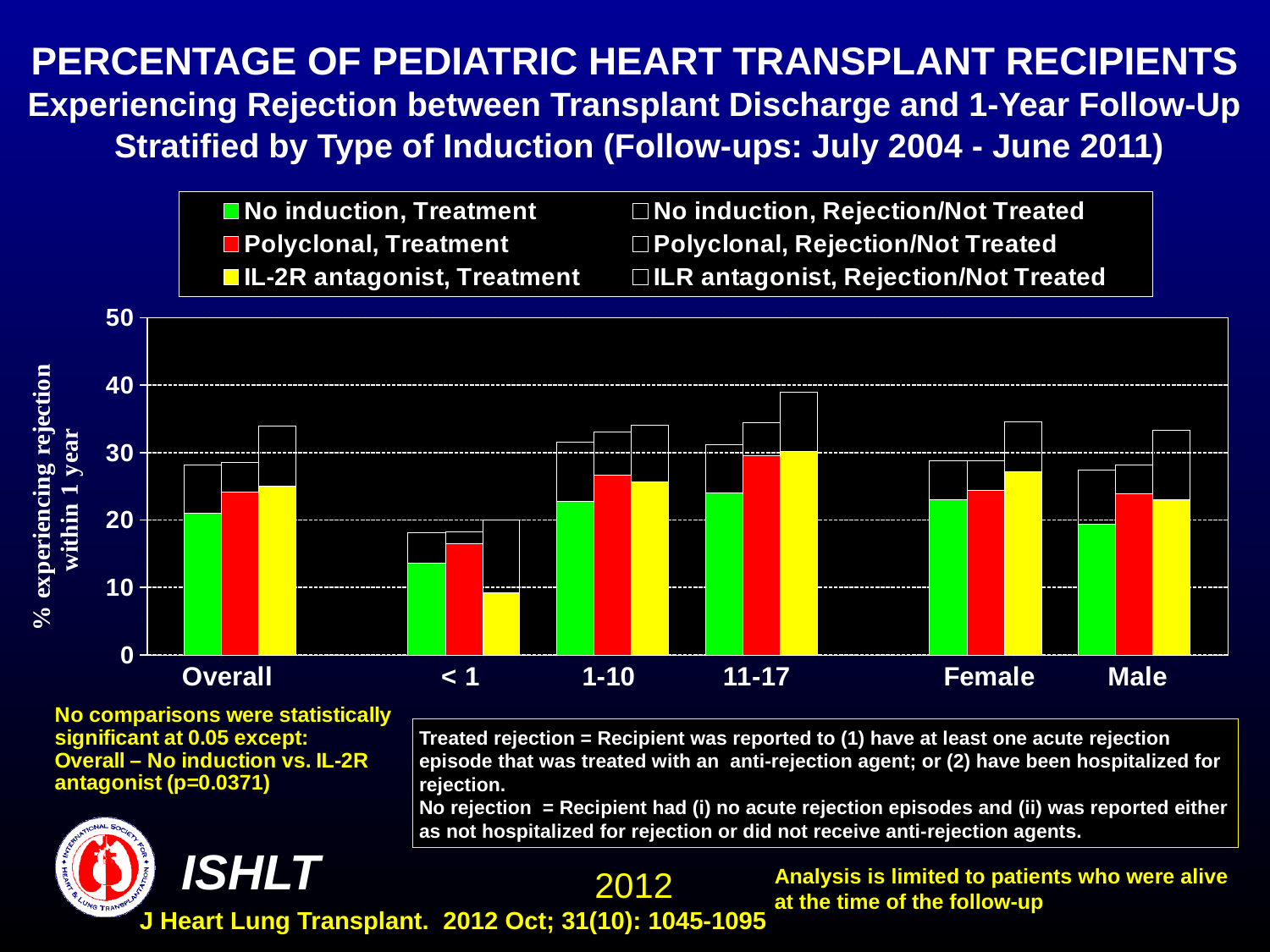
How many categories are shown along the x axis of the chart? 6 Which category has the lowest value for the IL-2R antagonist, Treatment series? < 1 In the 11-17 category, which is larger: the No induction, Treatment value or the Polyclonal, Treatment value? Polyclonal, Treatment What kind of chart is shown on the slide? bar chart Is the IL-2R antagonist, Treatment value for the Female category greater or less than 20? greater Is the Polyclonal, Treatment value for the 1-10 category greater or less than 20? greater Is the No induction, Treatment value for the < 1 category greater or less than 20? less In the < 1 category, which is larger: the Polyclonal, Treatment value or the IL-2R antagonist, Treatment value? Polyclonal, Treatment Which category has the highest value for the Polyclonal, Treatment series? 11-17 How many series does the chart's legend list? 6 Which category has the lowest value for the No induction, Treatment series? < 1 What colour represents the Polyclonal, Treatment series in the chart? red